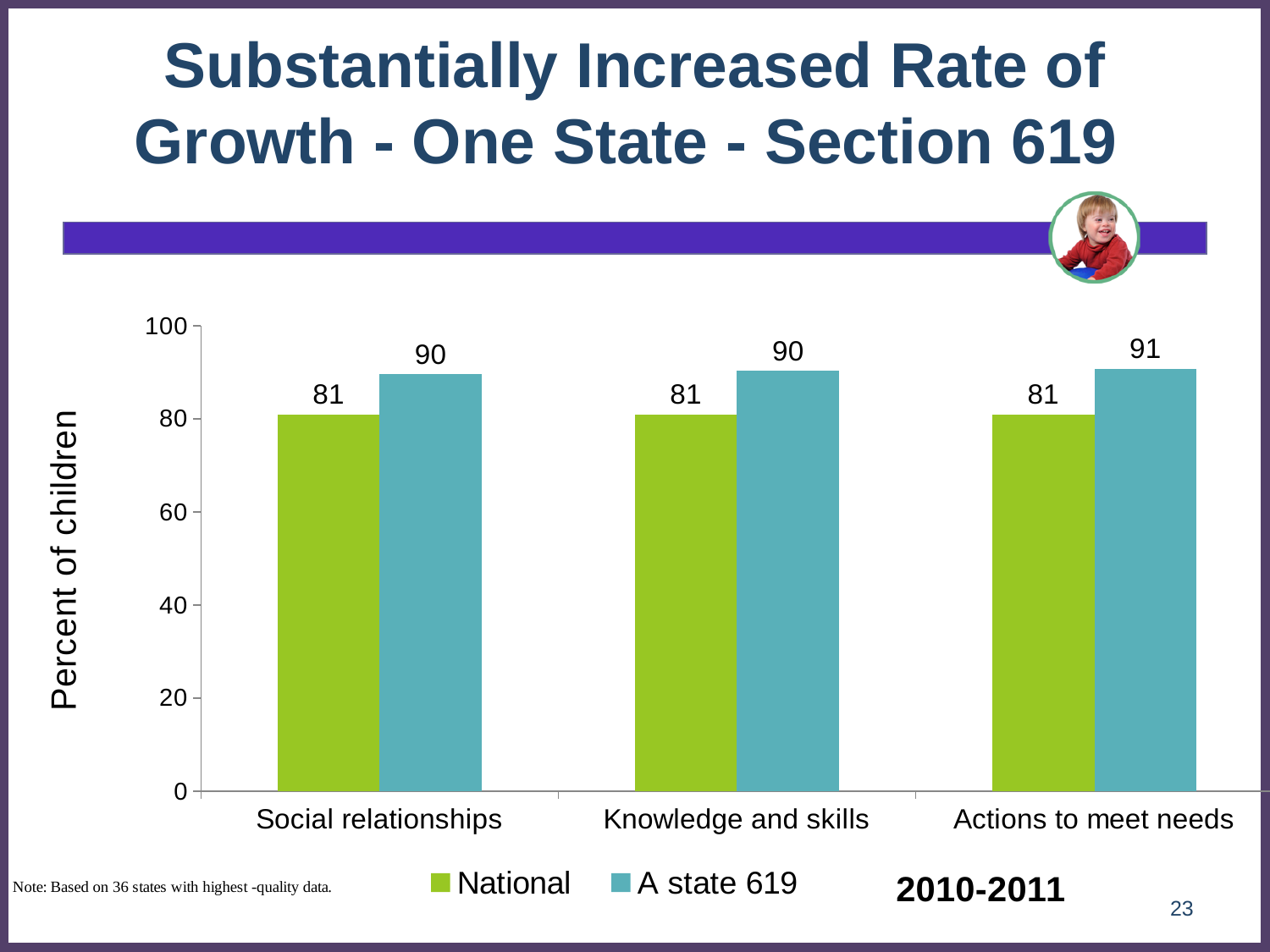
How many categories are shown on the x axis? 3 What is the label of the y axis? Percent of children Which is larger for Knowledge and skills, National or A state 619? A state 619 What kind of chart is shown on the slide? Bar chart What is the difference between A state 619 and National for Actions to meet needs? 10 What is the value for A state 619 for Knowledge and skills? 90 What is the National value for Actions to meet needs? 81 What is the difference between A state 619 and National for Social relationships? 9 What is the value for A state 619 for Actions to meet needs? 91 How many series does the legend list? 2 What is the National value for Social relationships? 81 Which category has the highest value for A state 619? Actions to meet needs